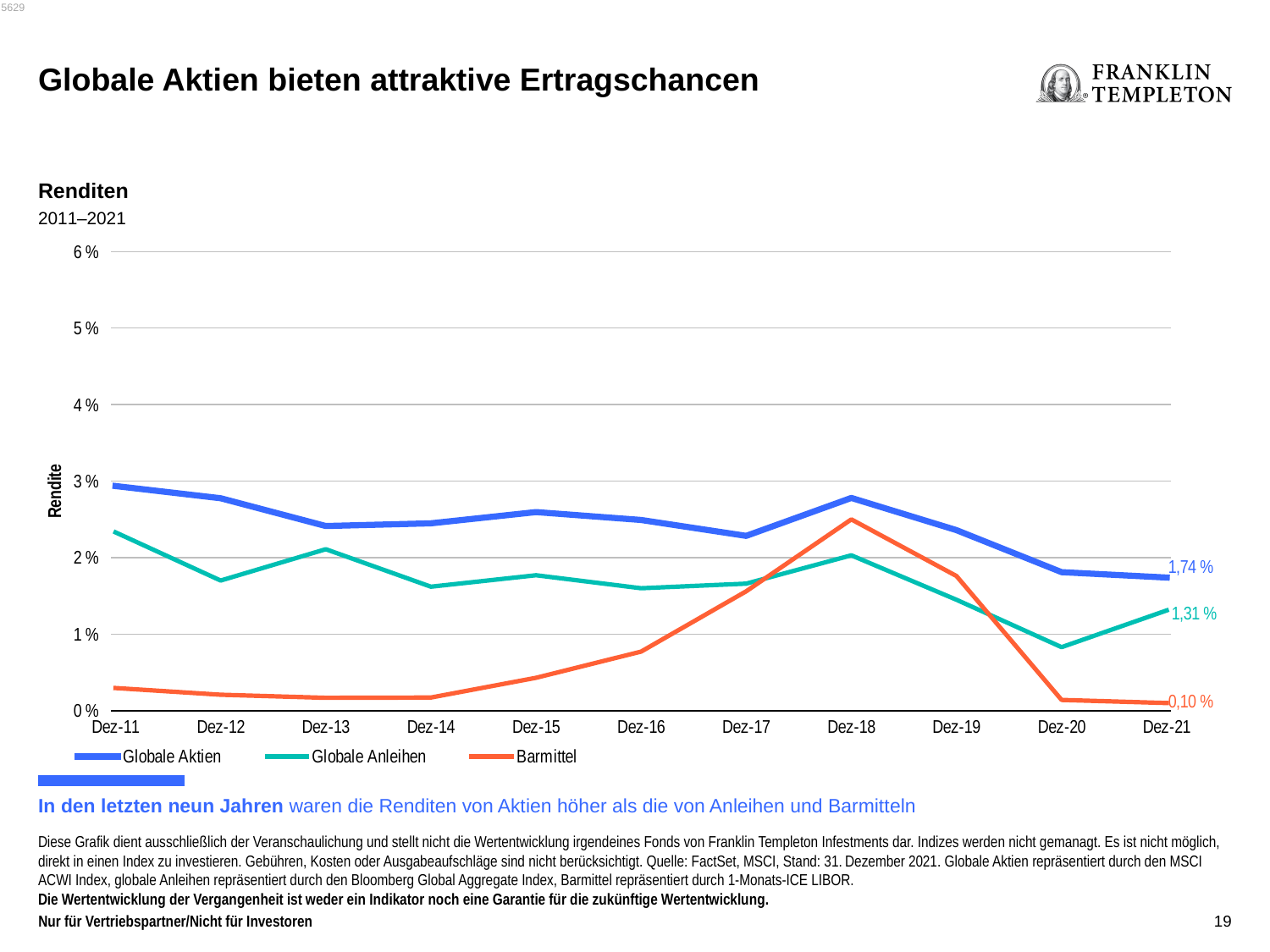
How many points are shown on the x axis? 11 How many series does the legend list? 3 What is the value for Globale Anleihen at Dez-21? 1,31 % What is the value for Barmittel at Dez-21? 0,10 % At Dez-21, which series has the highest value? Globale Aktien At Dez-21, which series has the lowest value? Barmittel What is the value for Globale Aktien at Dez-21? 1,74 % Is the value for Globale Aktien at Dez-11 greater or less than 2 %? greater At Dez-21, how much higher is Globale Aktien than Globale Anleihen? 0,43 % Is the value for Barmittel at Dez-14 greater or less than 1 %? less At Dez-21, which is larger: Globale Anleihen or Barmittel? Globale Anleihen What kind of chart is shown on the slide? line chart